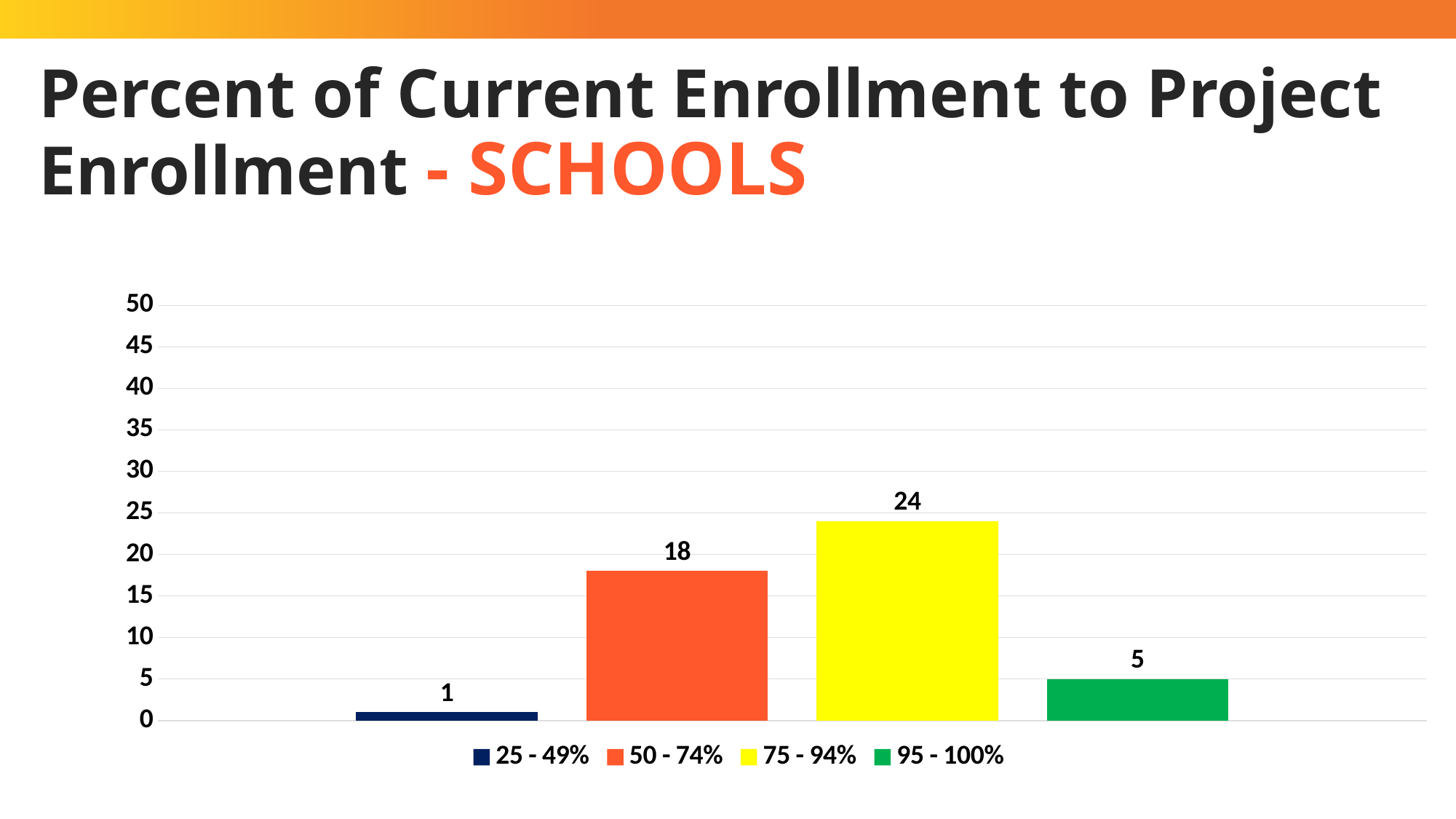
What is the value for the 25 - 49% category? 1 What is the value for the 50 - 74% category? 18 What colour is the bar for the 95 - 100% category? Green What is the value for the 95 - 100% category? 5 Which is larger, the value for 50 - 74% or the value for 95 - 100%? 50 - 74% Is the value for 75 - 94% greater or less than 20? greater What kind of chart is shown on the slide? Bar chart Which category has the lowest value? 25 - 49% What is the difference between the values for 75 - 94% and 50 - 74%? 6 What is the value for the 75 - 94% category? 24 How many categories are shown in the chart? 4 Which category has the highest value? 75 - 94%